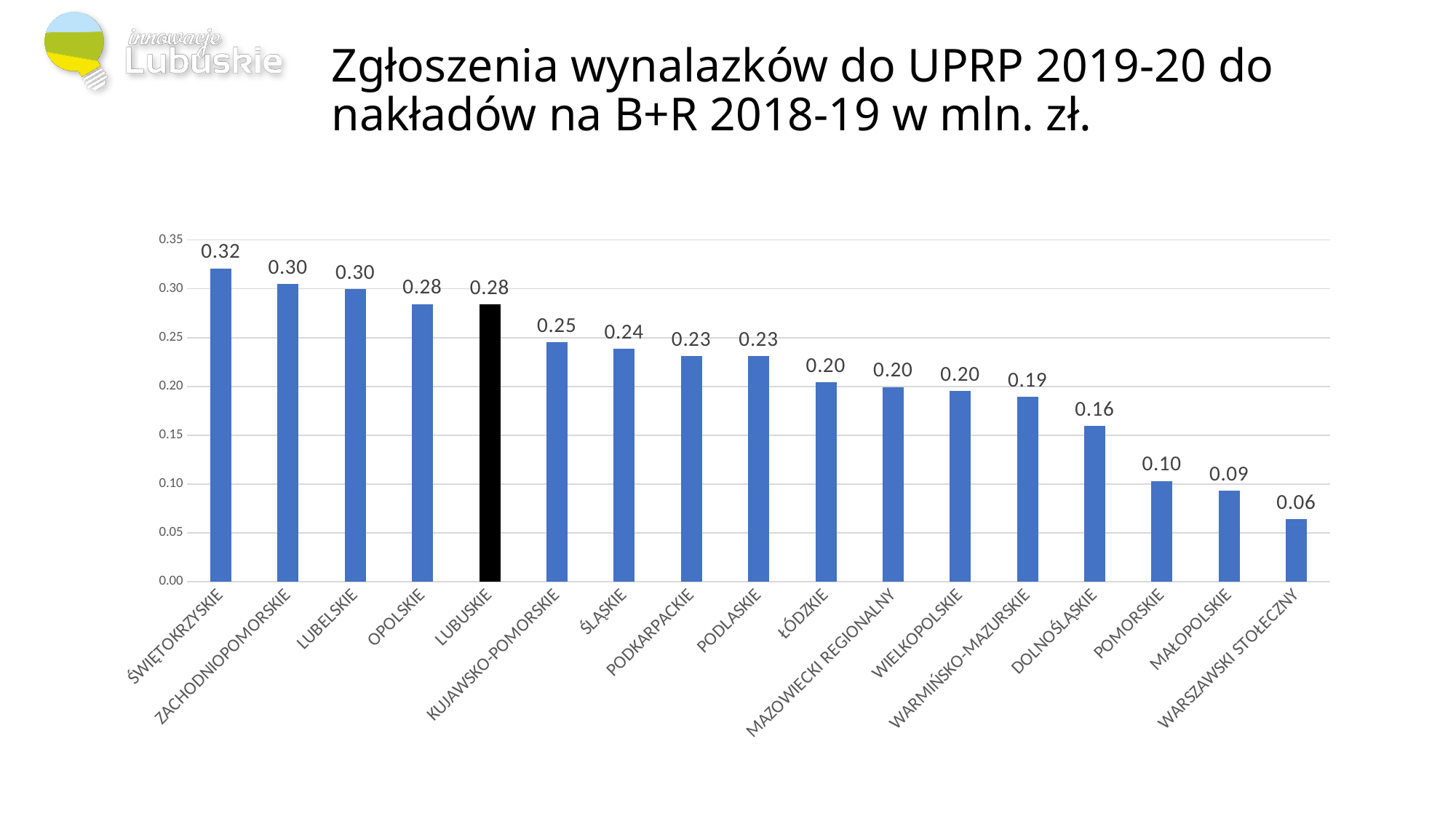
Which region has the lowest value? WARSZAWSKI STOŁECZNY Which region has the highest value? ŚWIĘTOKRZYSKIE Do the values rise or fall from left to right along the x axis? fall What kind of chart is shown on the slide? bar chart What is the value for KUJAWSKO-POMORSKIE? 0.25 What is the difference between the values for ŚWIĘTOKRZYSKIE and WARSZAWSKI STOŁECZNY? 0.26 What is the value for DOLNOŚLĄSKIE? 0.16 Is the value for ŚLĄSKIE greater or less than 0.20? greater How many regions are shown on the chart? 17 Which region's bar is coloured black instead of blue? LUBUSKIE What is the value for LUBUSKIE? 0.28 Which is larger, the value for DOLNOŚLĄSKIE or the value for POMORSKIE? DOLNOŚLĄSKIE